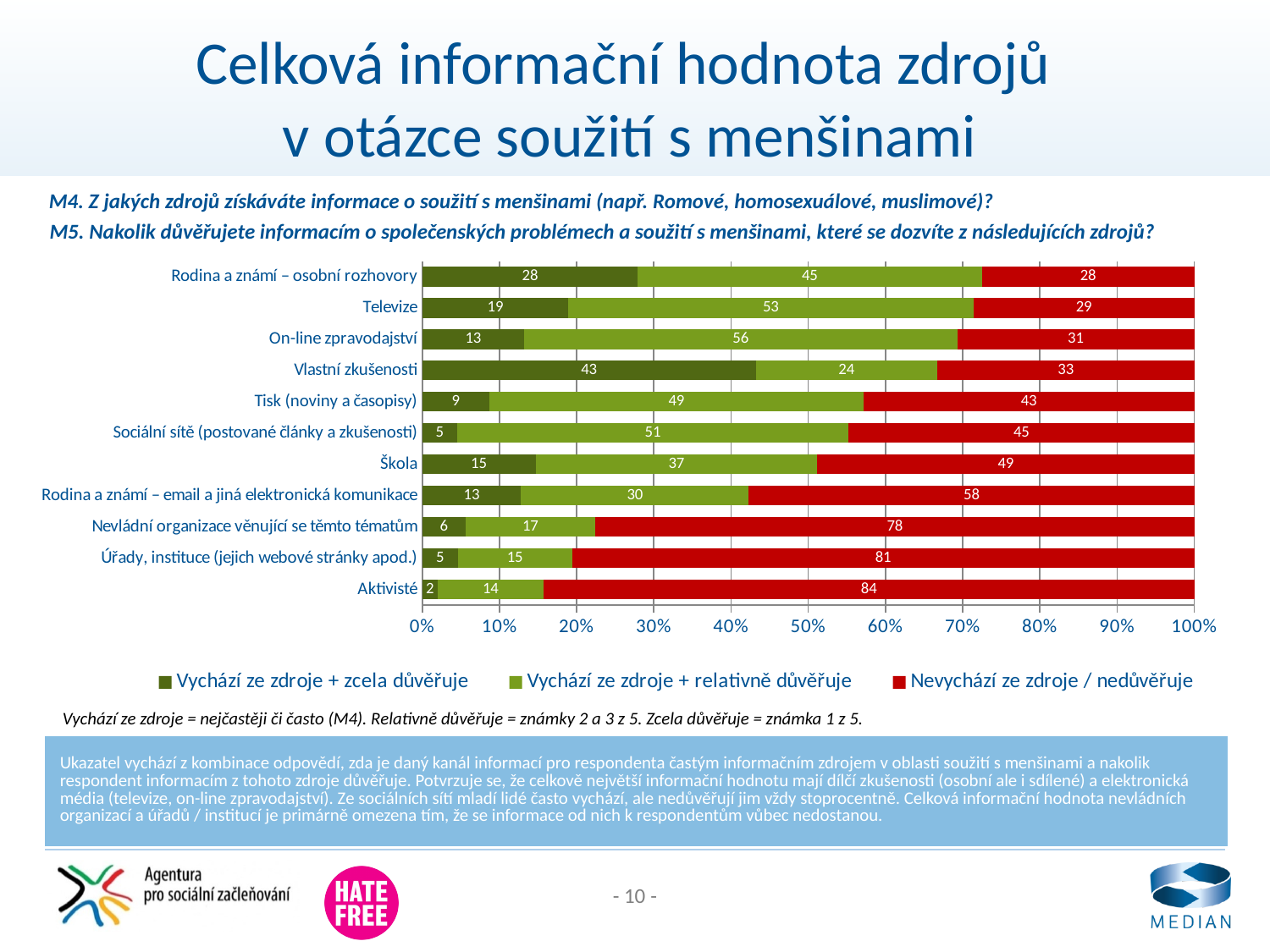
What is the total of the three segments for 'Tisk (noviny a časopisy)'? 101 How many series does the legend list? 3 How many categories (information sources) are plotted on the chart? 11 What kind of chart is shown on the slide? Stacked bar chart What is the value of 'Nevychází ze zdroje / nedůvěřuje' for 'Aktivisté'? 84 Which is larger: the 'Vychází ze zdroje + relativně důvěřuje' value for 'Televize' or for 'Škola'? Televize What is the value of 'Vychází ze zdroje + relativně důvěřuje' for 'On-line zpravodajství'? 56 What is the difference between the 'Nevychází ze zdroje / nedůvěřuje' values for 'Úřady, instituce (jejich webové stránky apod.)' and 'Televize'? 52 Which series is shown in red in the legend? Nevychází ze zdroje / nedůvěřuje Which category has the lowest value for 'Vychází ze zdroje + zcela důvěřuje'? Aktivisté What is the value of 'Vychází ze zdroje + zcela důvěřuje' for 'Vlastní zkušenosti'? 43 Which category has the highest value for 'Nevychází ze zdroje / nedůvěřuje'? Aktivisté